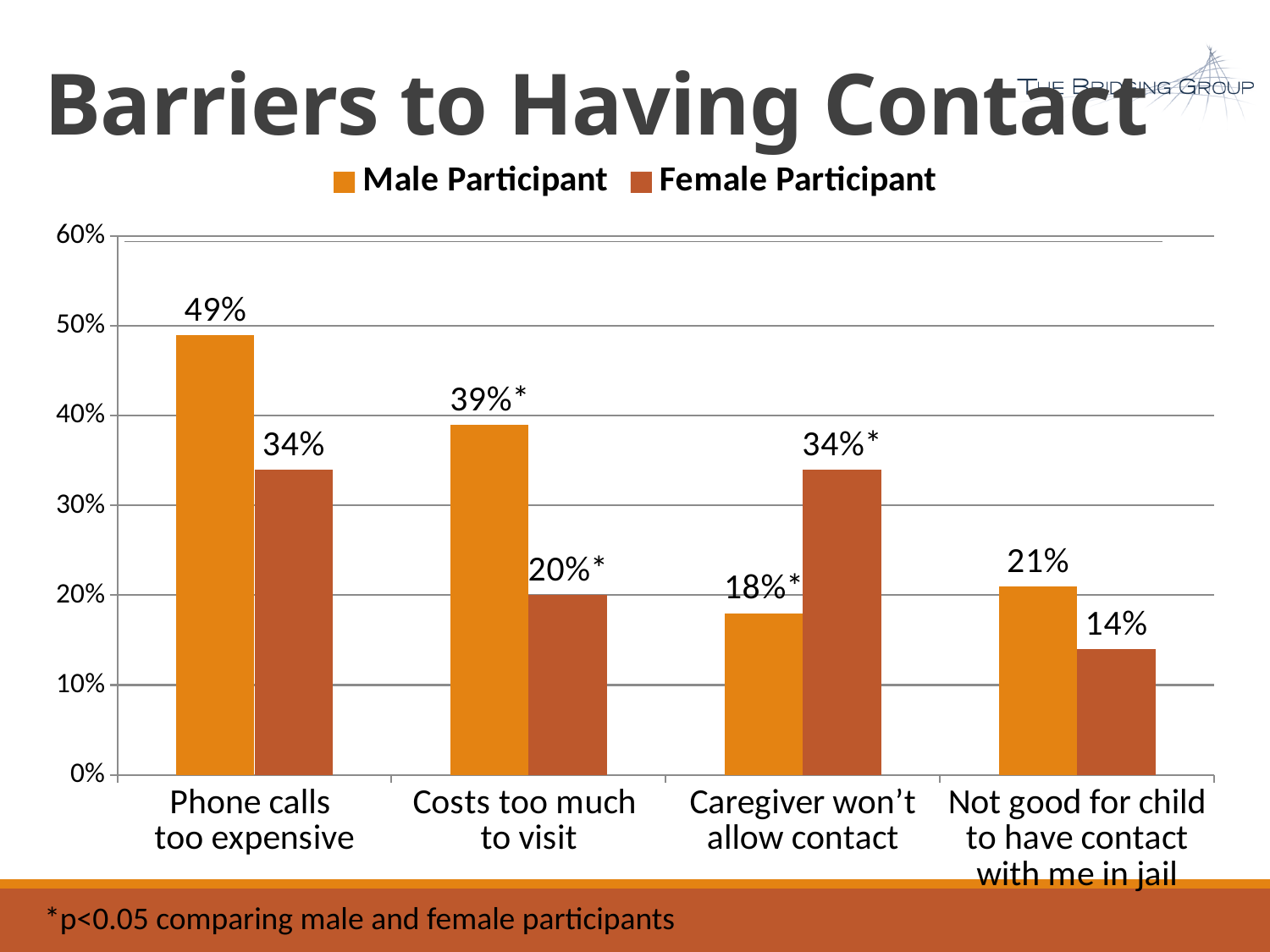
How many series does the legend list? 2 Is the Male Participant value for "Costs too much to visit" greater or less than 30%? greater How many categories are shown on the x axis? 4 For "Caregiver won't allow contact", which is larger: the Male Participant value or the Female Participant value? Female Participant What is the value for Female Participant for "Caregiver won't allow contact"? 34% What is the value for Female Participant for "Not good for child to have contact with me in jail"? 14% What is the title of the chart? Barriers to Having Contact Which category has the highest Male Participant value? Phone calls too expensive What is the value for Male Participant for "Phone calls too expensive"? 49% Which category has the lowest Female Participant value? Not good for child to have contact with me in jail What is the difference between the Male Participant and Female Participant values for "Costs too much to visit"? 19% What kind of chart is shown on the slide? Bar chart